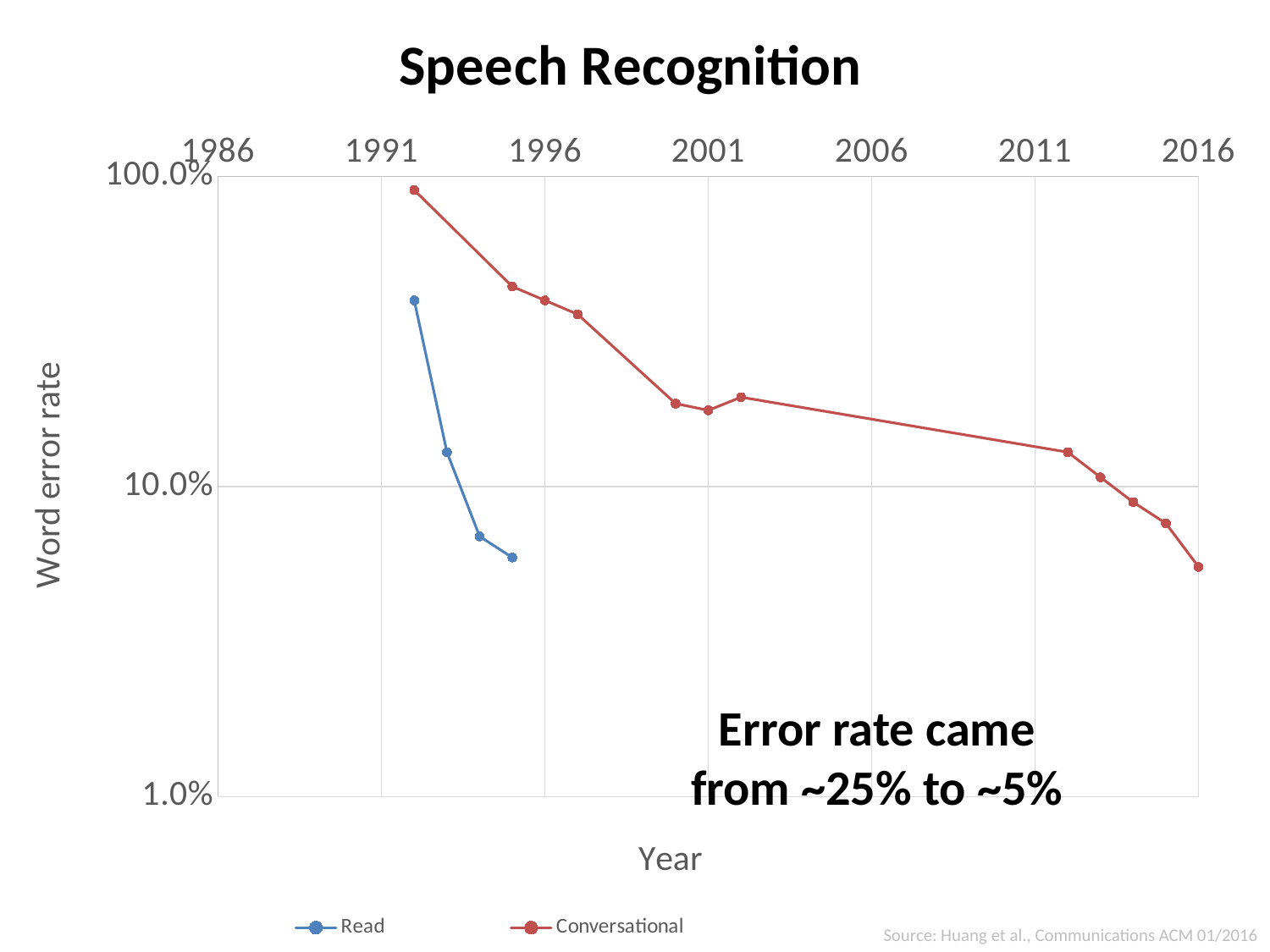
What kind of chart is shown on the slide? Line chart At their earliest points (around 1992), which series has the higher word error rate, Read or Conversational? Conversational Which series reaches the lowest word error rate on the chart? Conversational What are the names of the two series in the legend? Read and Conversational How many series does the legend list? 2 Is the first (earliest) value of the Conversational series greater or less than 10.0%? greater Is the last (2016) value of the Conversational series greater or less than 10.0%? less Does the word error rate for the Conversational series rise or fall over the years? Fall What is the title of the chart? Speech Recognition How many data points does the Read series have? 4 Is the last value of the Read series greater or less than 10.0%? less Does the word error rate for the Read series rise or fall over the years? Fall